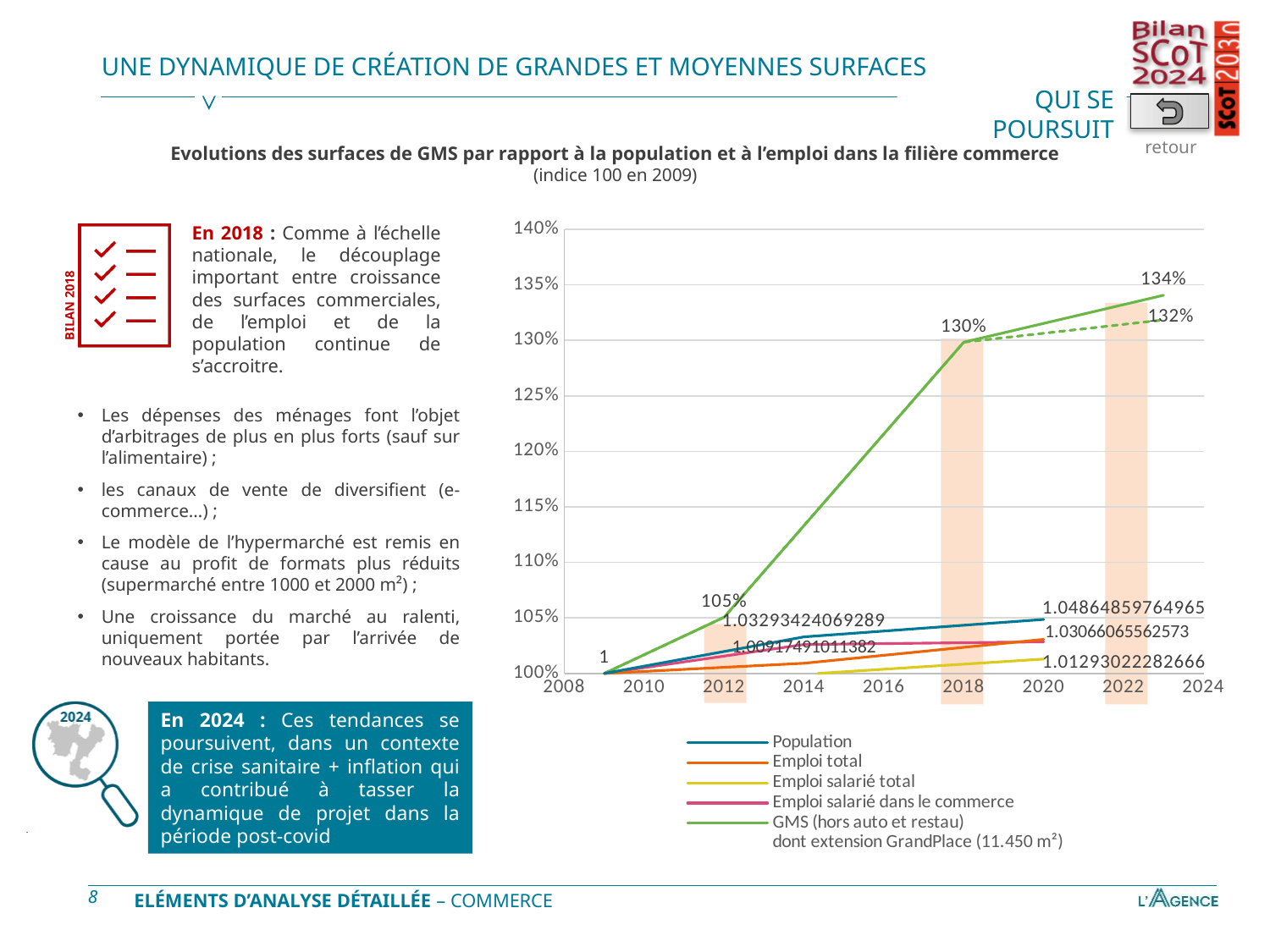
What is the value labelled at the end of the dashed line (dont extension GrandPlace)? 132% What is the base year of the index used in the chart, according to the subtitle? 2009 Does the GMS (hors auto et restau) line rise or fall from 2009 to 2018? rise What is the value labelled on the GMS (hors auto et restau) line in 2018? 130% What is the value labelled on the Population line at its right end (2020)? 1.04864859764965 How many series does the chart legend list? 5 What is the highest value labelled on the GMS (hors auto et restau) line? 134% What kind of chart is shown on the slide? line chart Is the value of the GMS (hors auto et restau) line in 2016 greater or less than 115%? greater Which series reaches the highest value on the chart? GMS (hors auto et restau) What is the value labelled on the GMS (hors auto et restau) line in 2012? 105% By how many percentage points does the GMS line rise between its 2012 label (105%) and its 2018 label (130%)? 25 percentage points